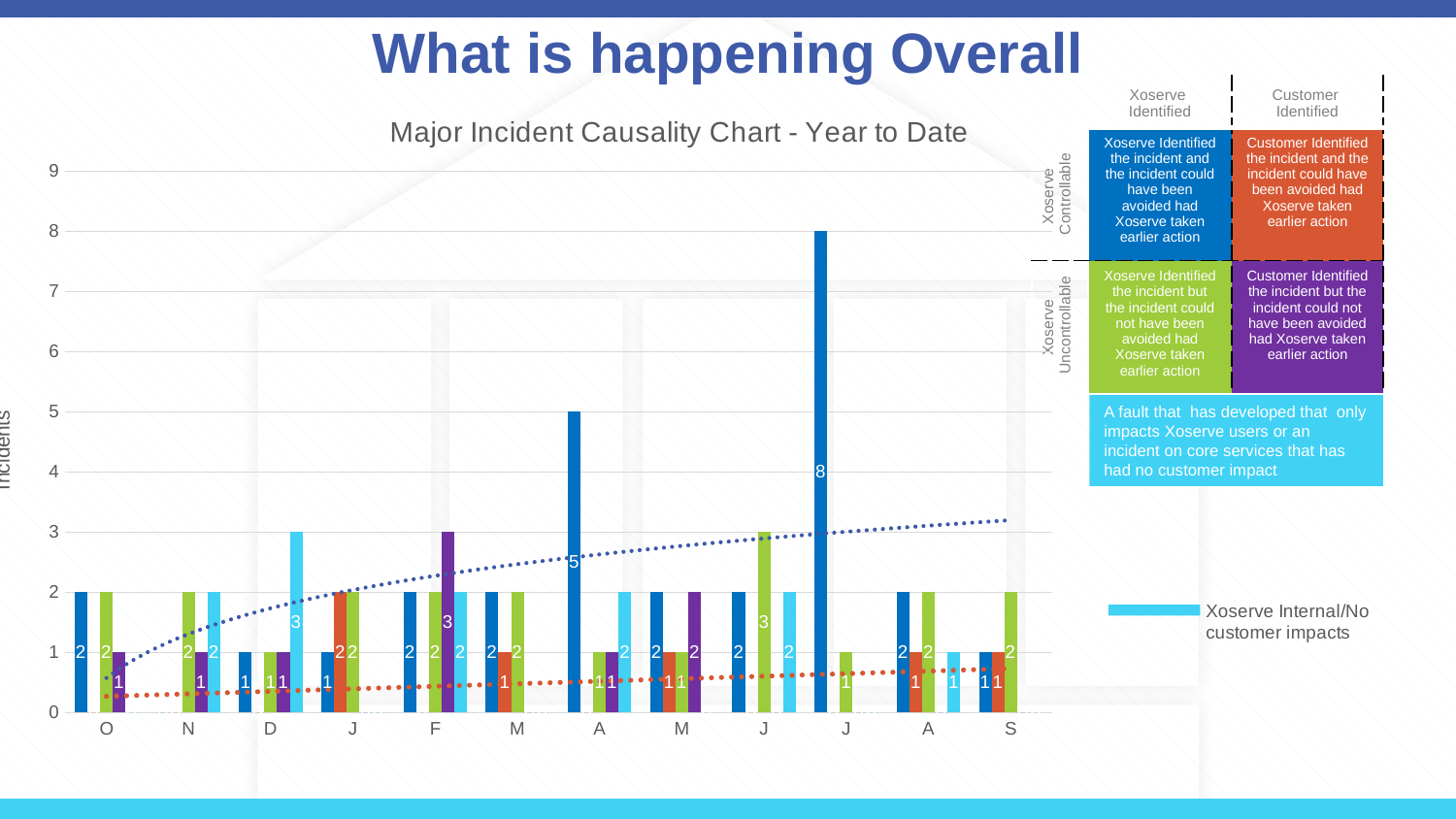
In the Major Incident Causality Chart, what is the difference between the tallest dark blue bar (8) and the dark blue bar for April (5)? 3 What is the value of the tallest dark blue bar in the Major Incident Causality Chart? 8 Is the tallest bar in the Major Incident Causality Chart greater or less than 7? greater In the Major Incident Causality Chart, which is larger: the dark blue bar for April or the purple bar for February? the dark blue bar for April What does the light blue colour represent according to the legend on the slide? Xoserve Internal/No customer impacts What type of chart is the Major Incident Causality Chart - Year to Date? bar chart What is the value of the dark blue bar for the first A month (April) in the Major Incident Causality Chart? 5 What is the highest value labelled on any bar in the Major Incident Causality Chart? 8 How many months are shown on the x axis of the Major Incident Causality Chart? 12 What is the value of the purple bar for F (February) in the Major Incident Causality Chart? 3 What is the maximum value shown on the y axis of the Major Incident Causality Chart? 9 What is the value of the light blue bar for D (December) in the Major Incident Causality Chart? 3